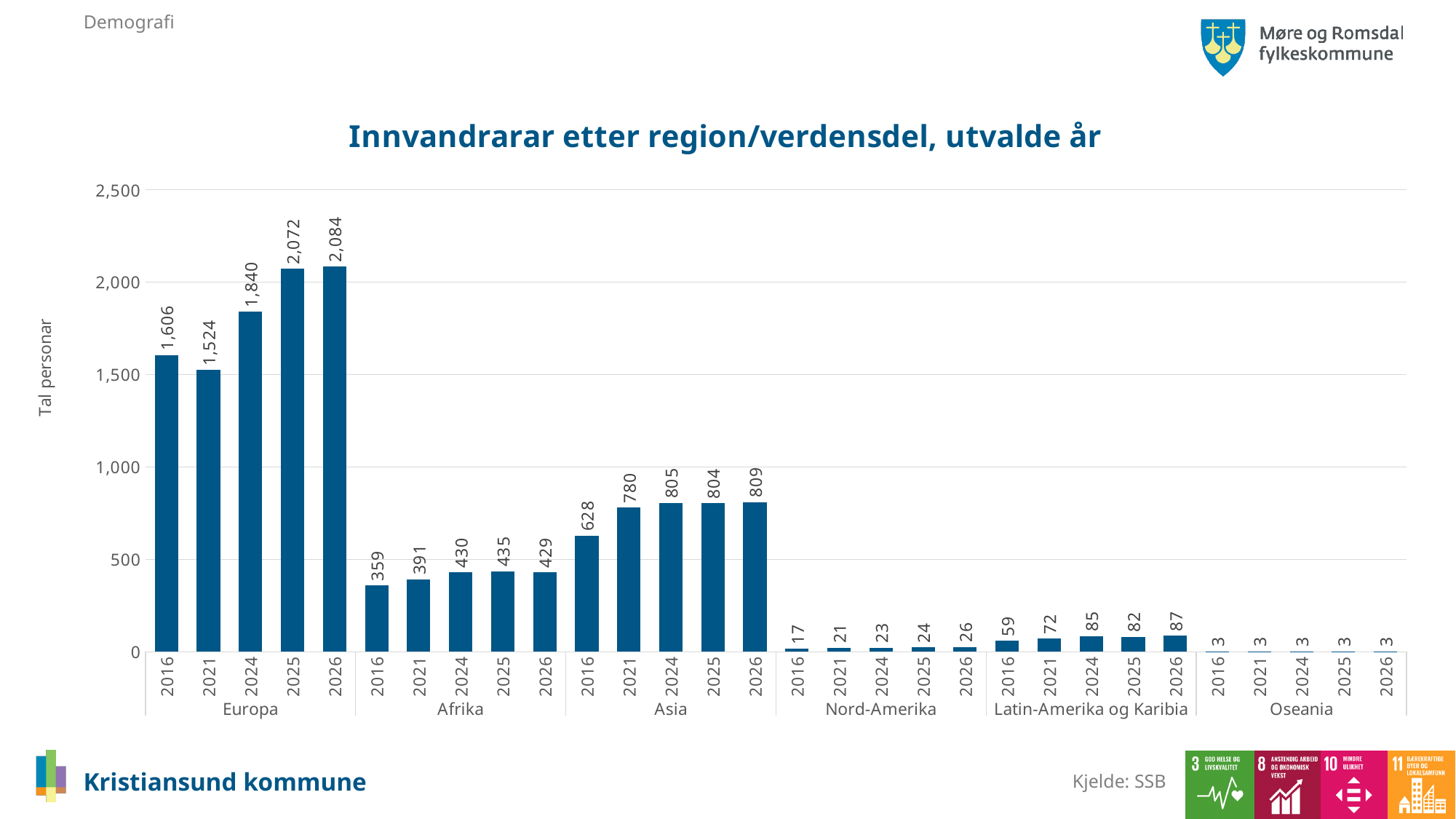
What is the value for Latin-Amerika og Karibia in 2024? 85 What is the title of the chart? Innvandrarar etter region/verdensdel, utvalde år What kind of chart is shown? Bar chart What is the difference between the Afrika values for 2025 and 2016? 76 How many regions are shown on the x axis? 6 What is the value for Europa in 2026? 2,084 Which region has the lowest value in 2016? Oseania What is the difference between the Europa values for 2026 and 2016? 478 What is the value for Asia in 2016? 628 What is the value for Nord-Amerika in 2025? 24 Which is larger, the Asia value for 2021 or the Afrika value for 2026? Asia 2021 Which region has the highest value in 2026? Europa